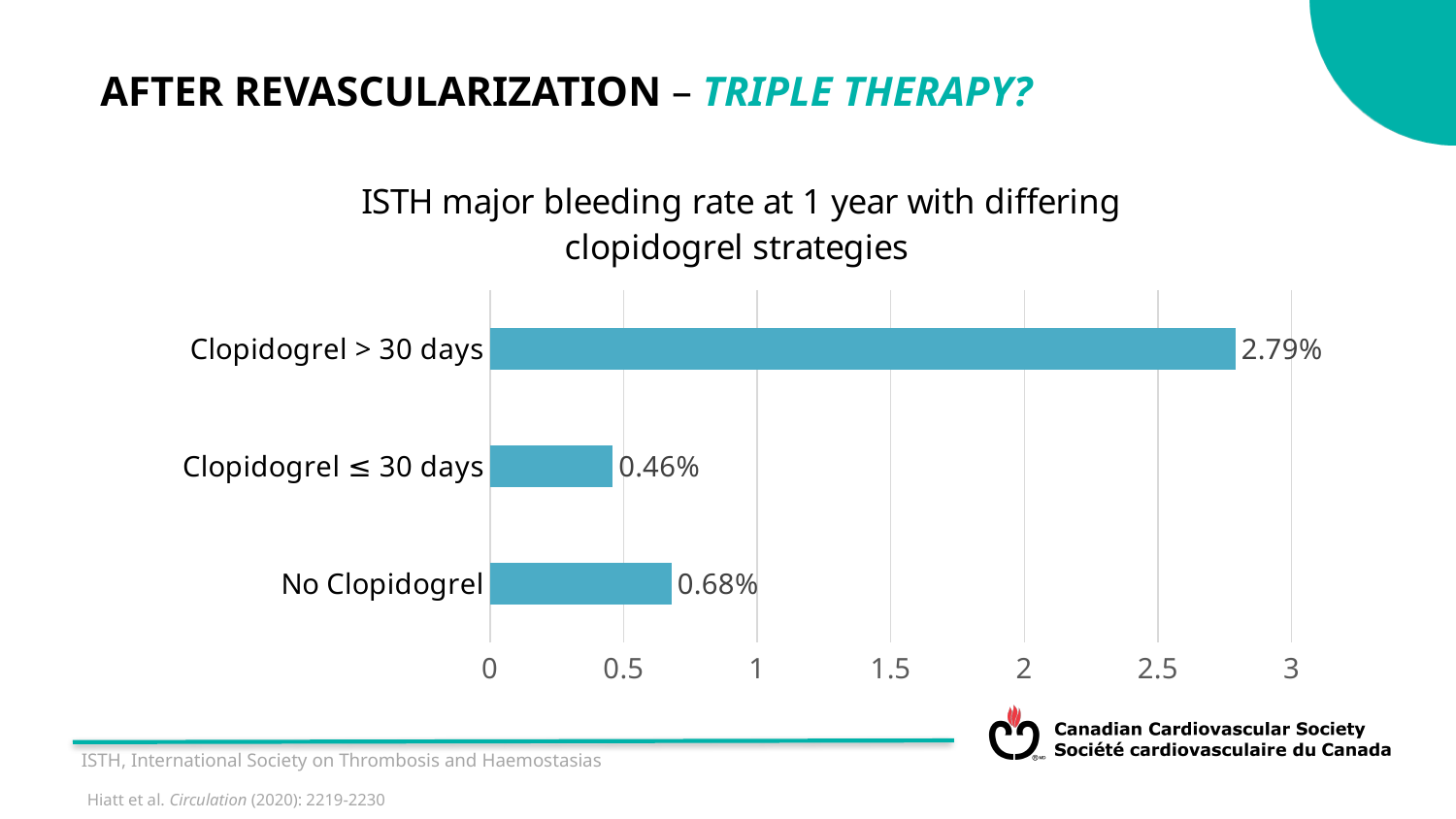
Which has a higher bleeding rate, No Clopidogrel or Clopidogrel ≤ 30 days? No Clopidogrel Which clopidogrel strategy has the highest major bleeding rate? Clopidogrel > 30 days Which clopidogrel strategy has the lowest major bleeding rate? Clopidogrel ≤ 30 days Is the value for Clopidogrel > 30 days greater or less than 2.5? greater What is the title of the chart? ISTH major bleeding rate at 1 year with differing clopidogrel strategies What is the ISTH major bleeding rate at 1 year for No Clopidogrel? 0.68% What is the difference in bleeding rate between Clopidogrel > 30 days and No Clopidogrel? 2.11% How many clopidogrel strategies are shown in the chart? 3 What is the ISTH major bleeding rate at 1 year for Clopidogrel ≤ 30 days? 0.46% What is the ISTH major bleeding rate at 1 year for Clopidogrel > 30 days? 2.79% What is the difference in bleeding rate between No Clopidogrel and Clopidogrel ≤ 30 days? 0.22% What kind of chart is shown on the slide? Bar chart